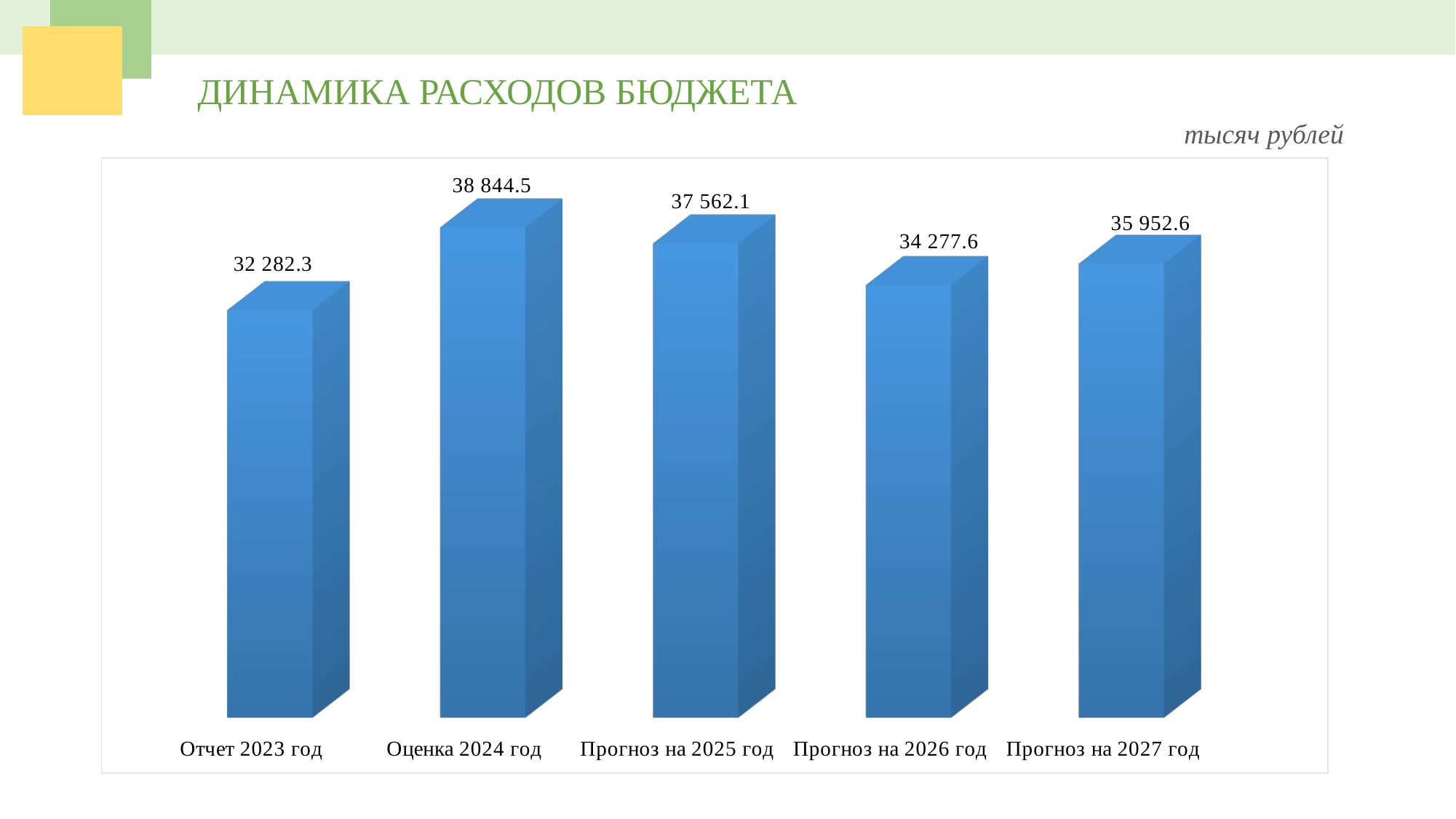
What is the difference between the values for Оценка 2024 год and Отчет 2023 год? 6 562.2 What kind of chart is shown on the slide? Bar chart How many categories are shown on the chart? 5 What is the value for Отчет 2023 год? 32 282.3 Which is larger, the value for Прогноз на 2025 год or Прогноз на 2026 год? Прогноз на 2025 год Which category has the lowest value? Отчет 2023 год Which category has the highest value? Оценка 2024 год What is the title of the chart? ДИНАМИКА РАСХОДОВ БЮДЖЕТА What is the value for Прогноз на 2027 год? 35 952.6 What is the value for Оценка 2024 год? 38 844.5 What is the value for Прогноз на 2025 год? 37 562.1 What is the difference between the values for Прогноз на 2027 год and Прогноз на 2026 год? 1 675.0